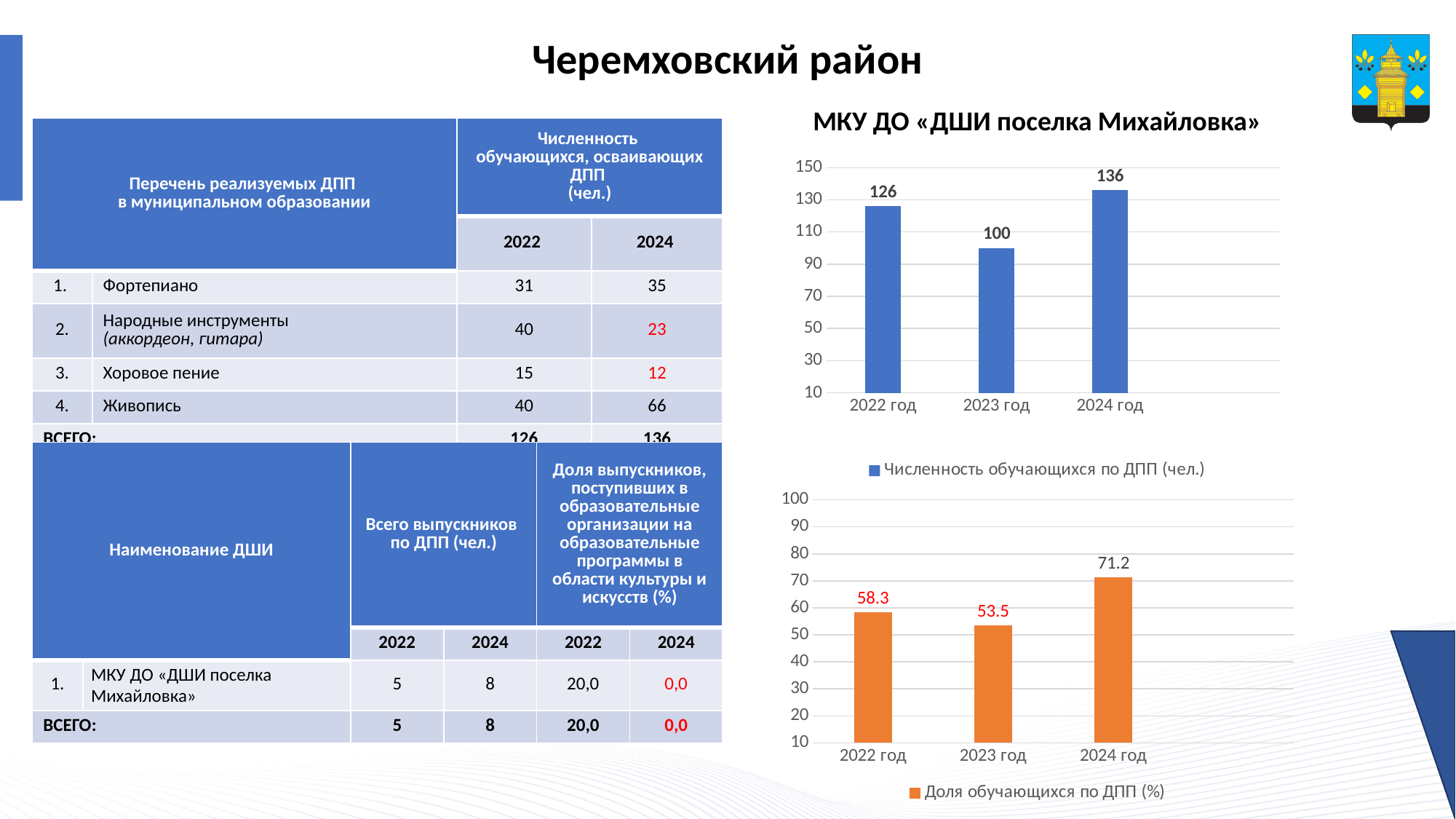
In the bottom chart (Доля обучающихся по ДПП), which year has the lowest value? 2023 год In the bottom chart (Доля обучающихся по ДПП), what is the value for 2022 год? 58.3 In the bottom chart (Доля обучающихся по ДПП), is the value for 2022 год or 2024 год larger? 2024 год In the top chart (Численность обучающихся по ДПП), what is the value for 2023 год? 100 In the bottom chart (Доля обучающихся по ДПП), what is the value for 2024 год? 71.2 In the top chart (Численность обучающихся по ДПП), what is the value for 2024 год? 136 What type of chart is the bottom chart (Доля обучающихся по ДПП)? Bar chart In the top chart (Численность обучающихся по ДПП), how many years are shown on the x axis? 3 In the bottom chart (Доля обучающихся по ДПП), what is the difference between the values for 2024 год and 2023 год? 17.7 In the top chart (Численность обучающихся по ДПП), what is the difference between the values for 2024 год and 2022 год? 10 In the top chart (Численность обучающихся по ДПП), which year has the lowest value? 2023 год In the top chart (Численность обучающихся по ДПП), which year has the highest value? 2024 год